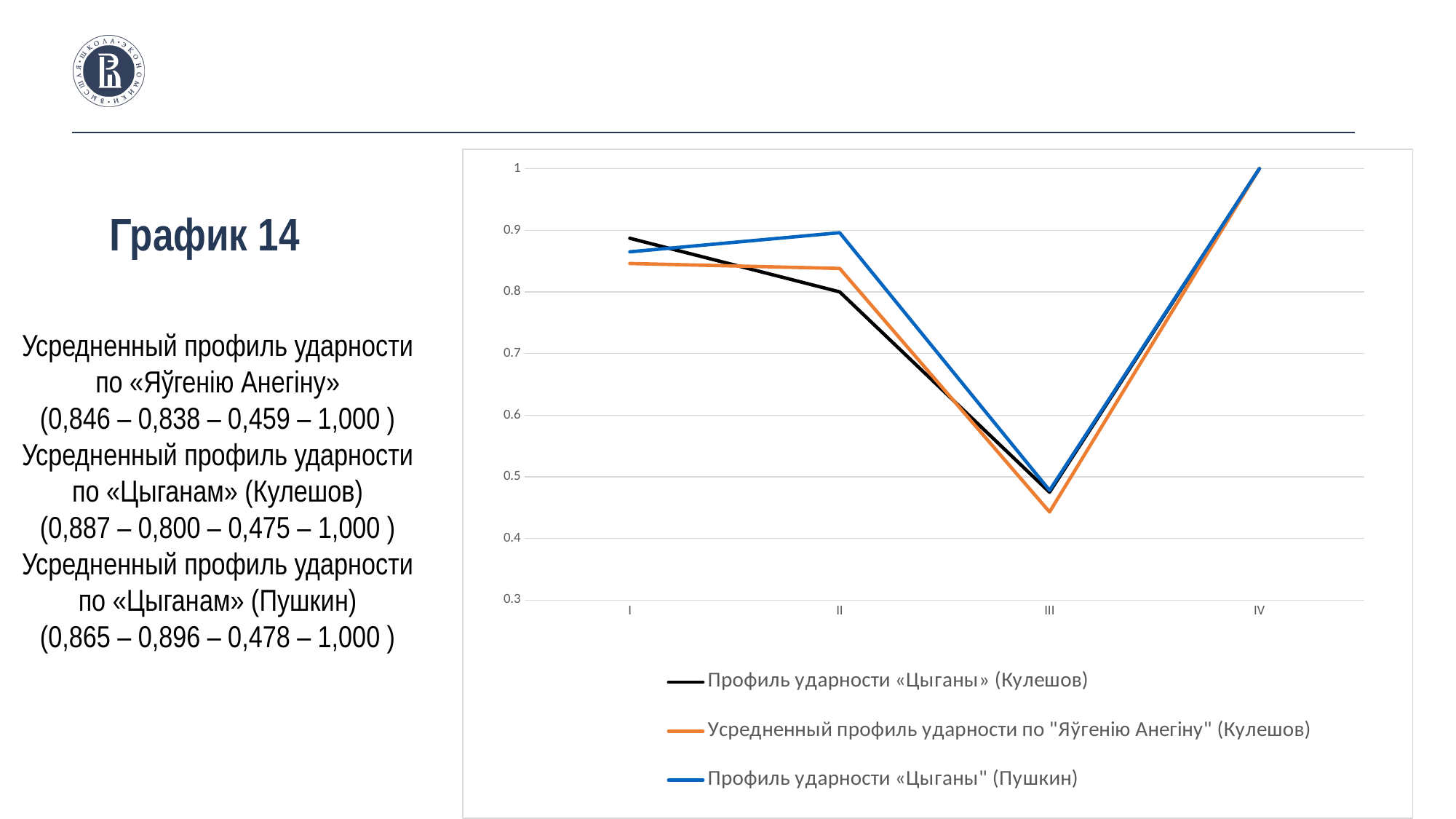
At point II, which line is higher: the blue line (Пушкин) or the black line (Кулешов)? blue line (Пушкин) Which x-axis point has the highest value for all three series? IV What is the title of the slide above the chart? График 14 How many points are on the x axis of the chart? 4 How many series does the legend list? 3 Do the values of all three lines rise or fall from point III to point IV? rise Which x-axis point has the lowest value for all three series? III Do the values of all three lines rise or fall from point II to point III? fall Is the value of the blue line (Пушкин) at point III greater or less than 0.5? less Is the value of the black line (Кулешов) at point I greater or less than 0.8? greater What kind of chart is shown on the slide? line chart What colour is the line for «Профиль ударности «Цыганы» (Кулешов)»? black